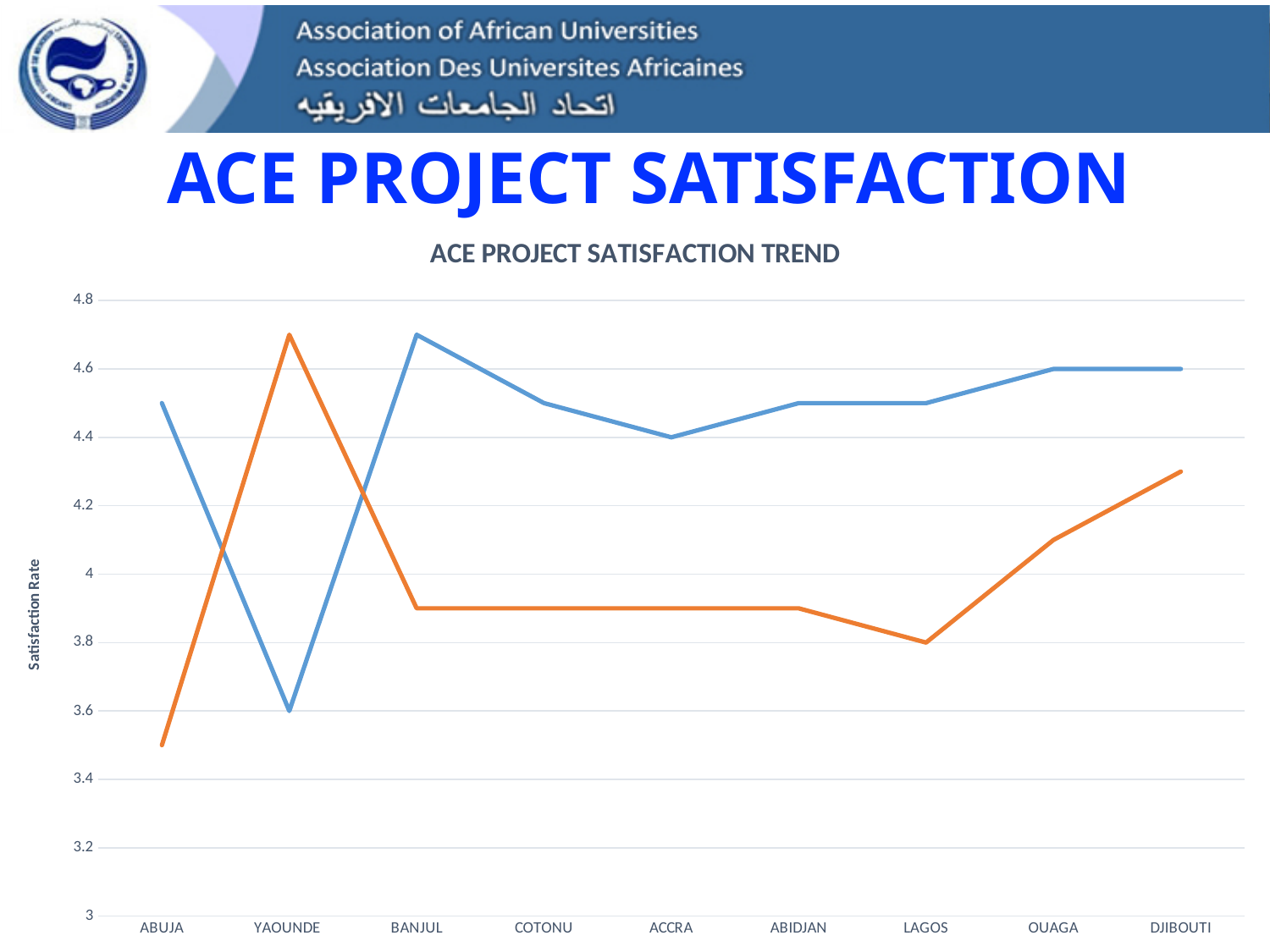
Does the orange line rise or fall from LAGOS to DJIBOUTI? rise What is the value of the orange line at LAGOS? 3.8 At which category does the blue line reach its lowest value? YAOUNDE What is the title of the chart? ACE PROJECT SATISFACTION TREND How many categories are shown along the x axis of the chart? 9 What is the value of the blue line at DJIBOUTI? 4.6 At which category does the orange line reach its highest value? YAOUNDE Is the value of the orange line at COTONU greater or less than 4? less What is the value of the blue line at YAOUNDE? 3.6 At which category does the orange line reach its lowest value? ABUJA What kind of chart is shown on the slide? Line chart What is the label on the vertical axis of the chart? Satisfaction Rate